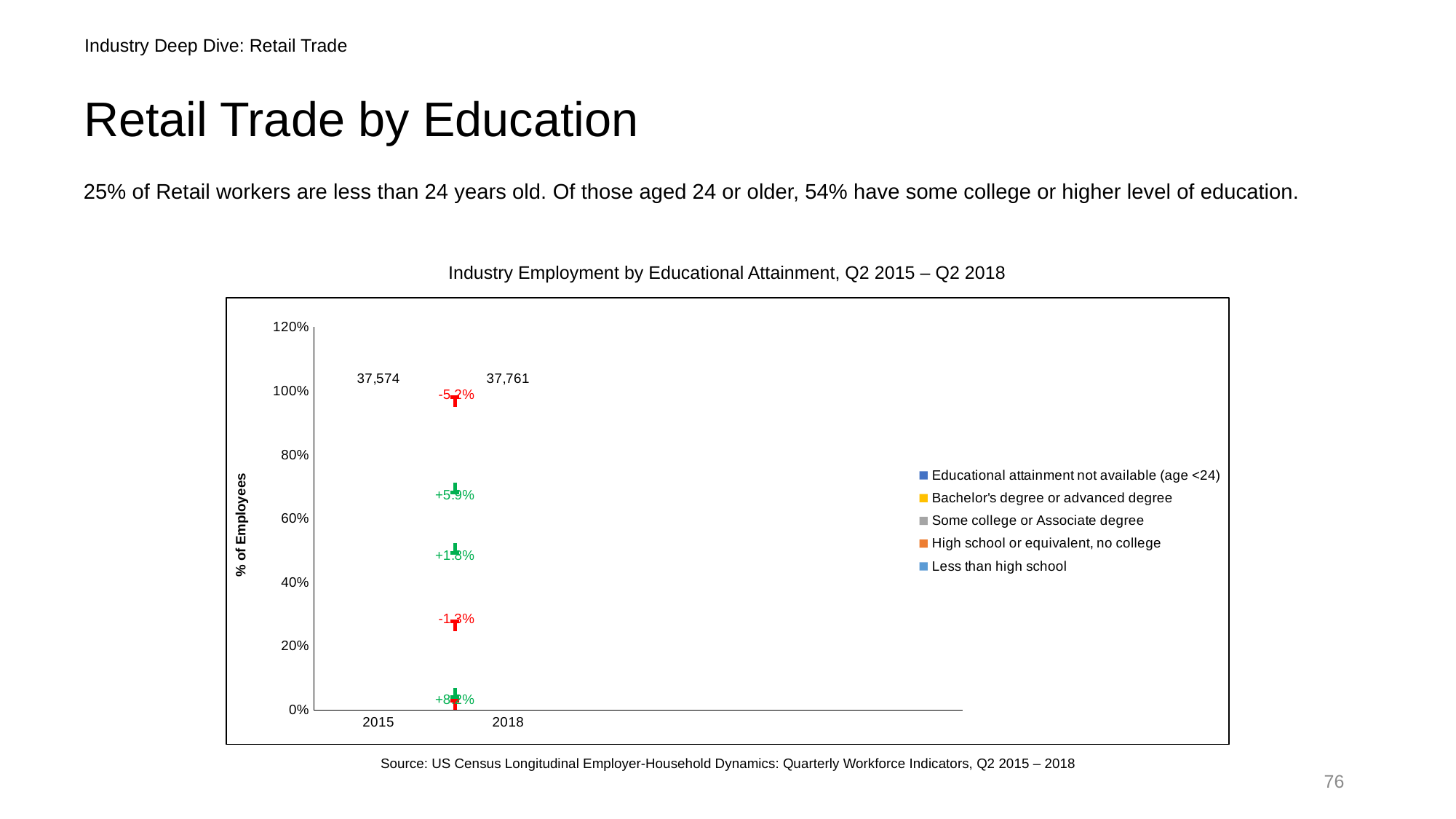
What is the difference between the total employment figures printed for 2018 and 2015? 187 What change label is printed in red near the 100% line between the two bars? -5.2% What total employment figure is printed above the 2018 bar? 37,761 What is the highest percentage tick shown on the y axis? 120% How many series does the chart's legend list? 5 What is the title of the chart? Industry Employment by Educational Attainment, Q2 2015 – Q2 2018 How many years are shown on the x axis of the chart? 2 What change label is printed in green near the 70% level between the two bars? +5.9% Which year has the larger total employment figure printed above it, 2015 or 2018? 2018 What total employment figure is printed above the 2015 bar? 37,574 What is the label on the y axis of the chart? % of Employees